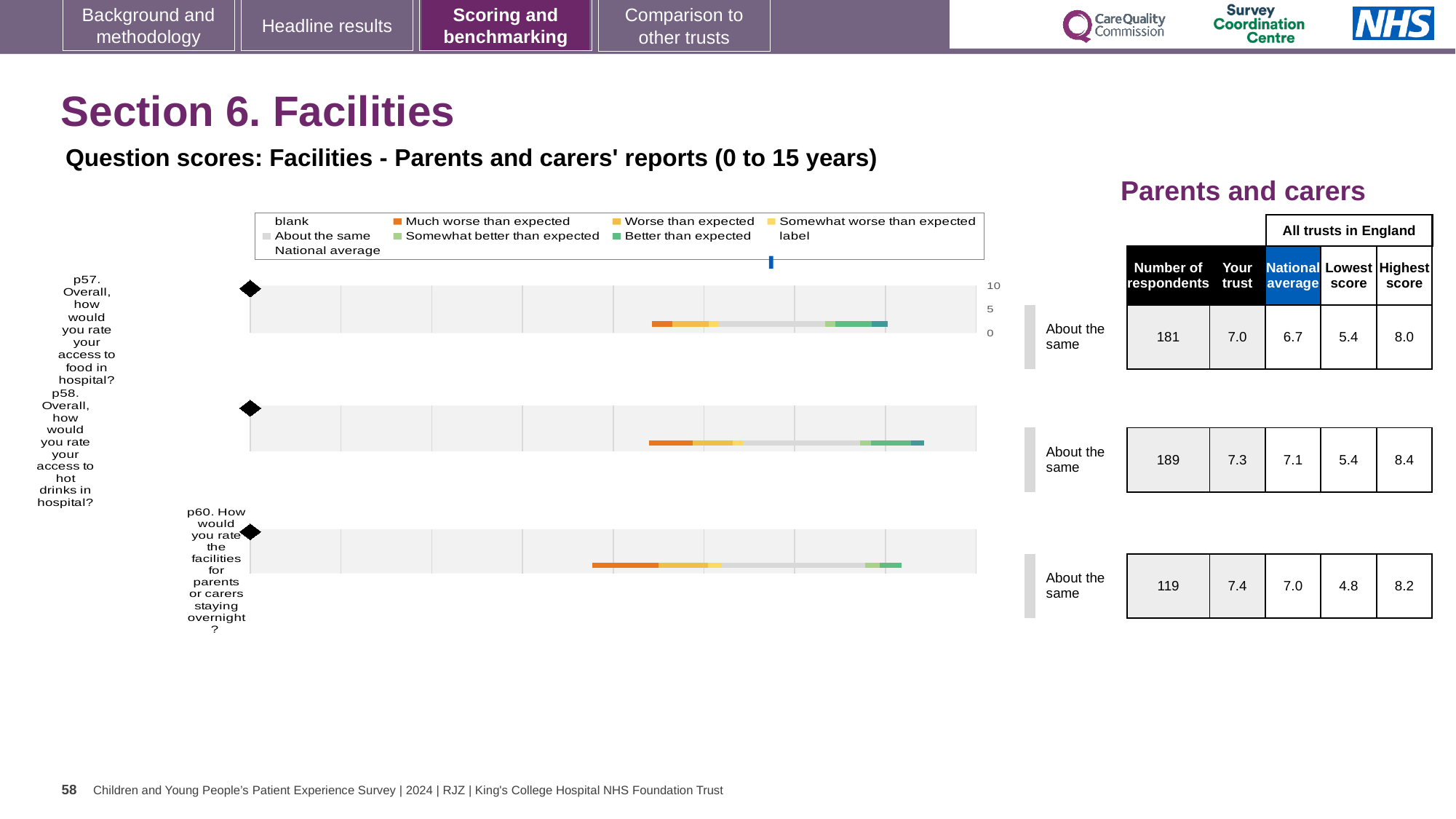
What is the difference between the highest score and the lowest score for p57? 2.6 For p58, which is larger: the 'Your trust' score or the national average? Your trust Which question has the lowest 'Lowest score' across all trusts in England? p60 Which question has the highest 'Your trust' score? p60 What benchmark category is shown for p57? About the same What is the 'Your trust' score for p57 (access to food in hospital)? 7.0 What is the highest tick value shown on the score axis? 10 What is the highest score among all trusts in England for p58? 8.4 How many survey questions are plotted on the chart? 3 How many respondents answered p60 (facilities for parents or carers staying overnight)? 119 What is the national average score for p58 (access to hot drinks in hospital)? 7.1 What kind of chart is used to show the question scores? bar chart